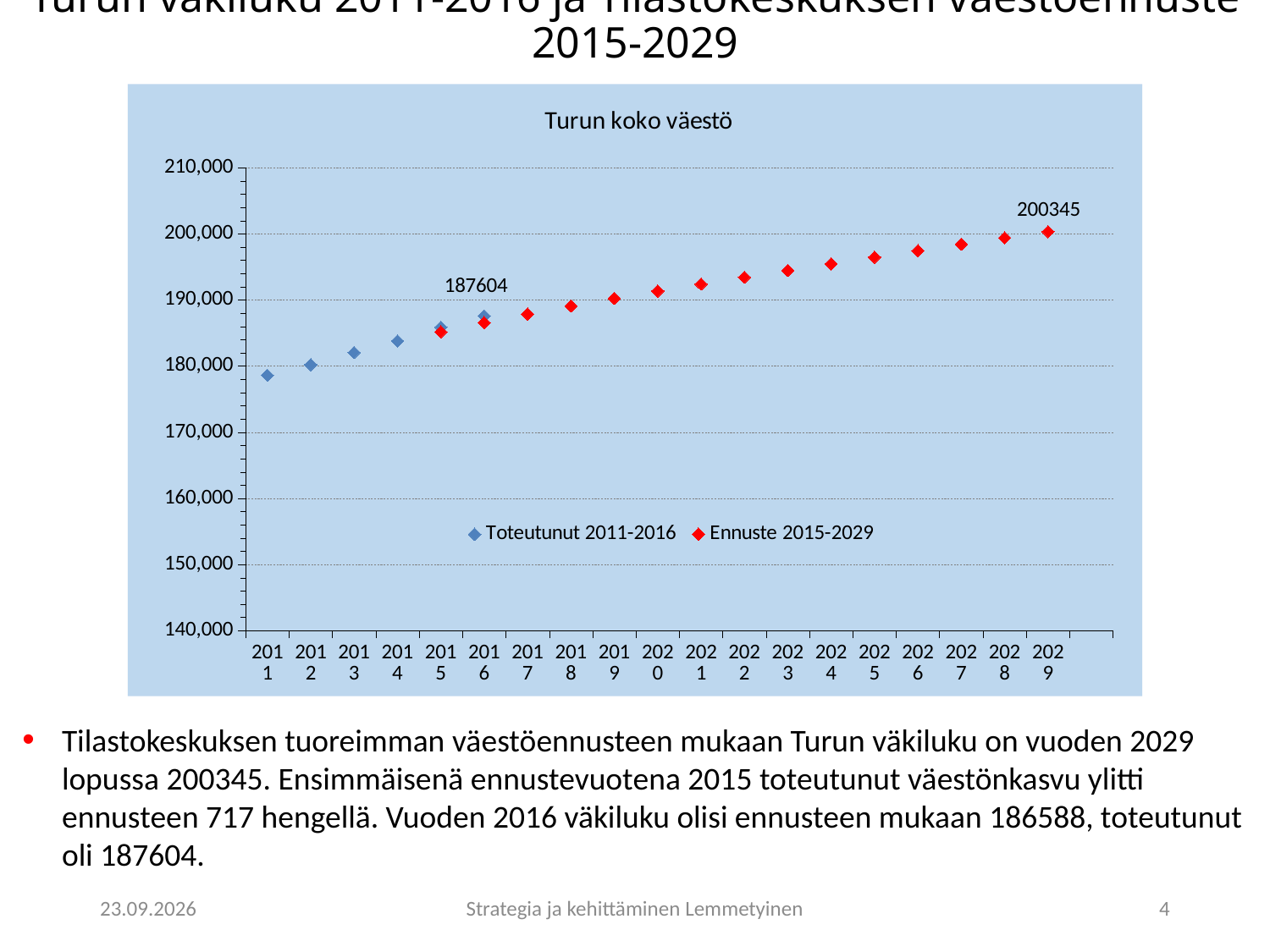
Which year has the highest Ennuste 2015-2029 value? 2029 What kind of chart is this? scatter chart What is the title of the chart? Turun koko väestö How many years are shown on the x axis? 19 What is the value of the Toteutunut 2011-2016 series for 2016? 187604 What is the value of the Ennuste 2015-2029 series for 2029? 200345 Is the Ennuste 2015-2029 value for 2025 greater or less than 190,000? greater How many series does the legend list? 2 What is the difference between the 2029 Ennuste value and the 2016 Toteutunut value? 12741 Is the Toteutunut 2011-2016 value for 2011 greater or less than 180,000? less Which year has the lowest Toteutunut 2011-2016 value? 2011 Do the Ennuste 2015-2029 values rise or fall from 2015 to 2029? rise